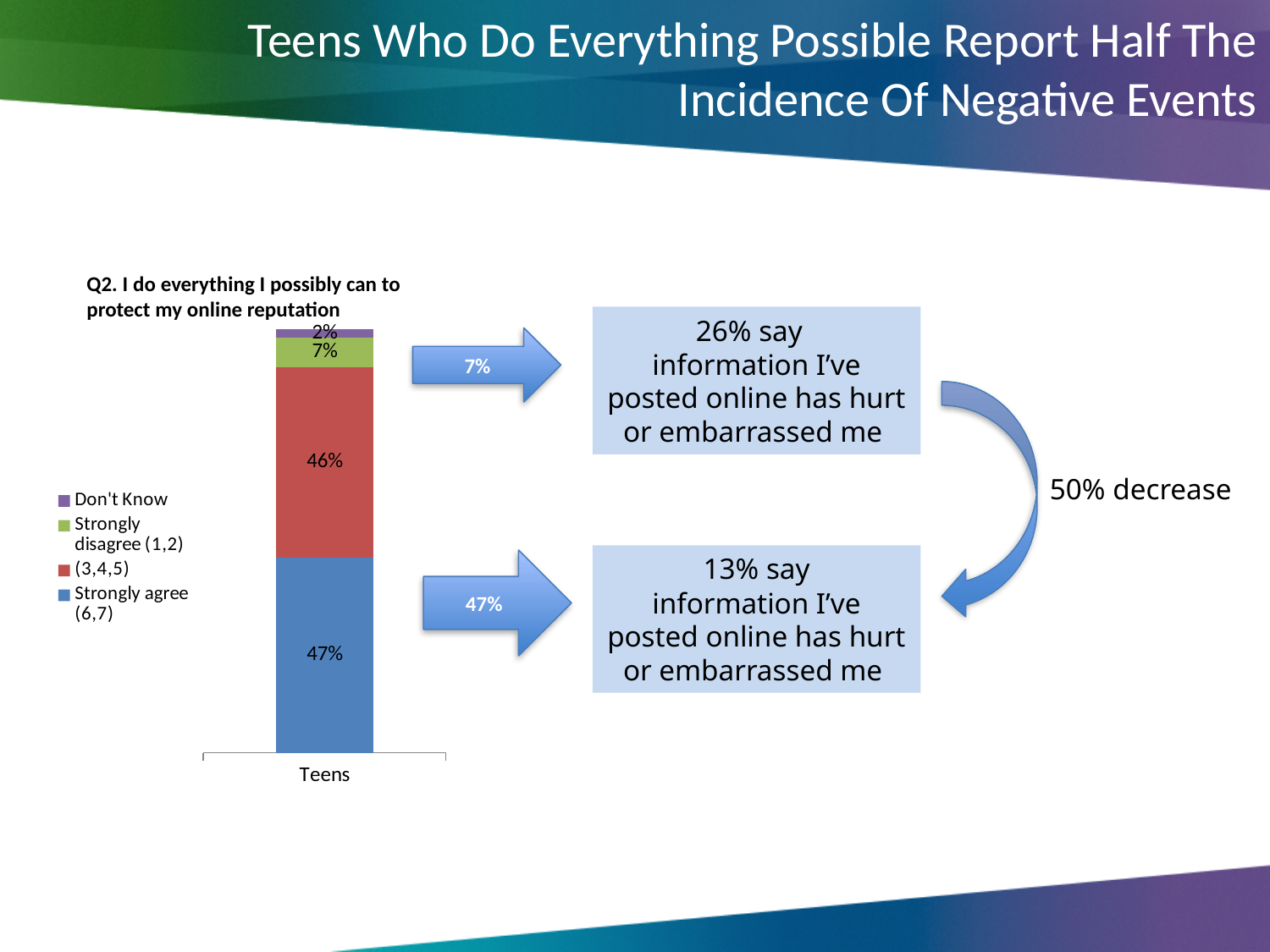
Which segment of the Teens bar is the smallest? Don't Know What percentage of Teens are in the Strongly agree (6,7) segment? 47% Which segment of the Teens bar is the largest? Strongly agree (6,7) What percentage of Teens are in the Strongly disagree (1,2) segment? 7% What is the title of the chart? Q2. I do everything I possibly can to protect my online reputation What percentage of Teens are in the (3,4,5) segment? 46% What kind of chart is shown on the slide? Stacked bar chart How many categories are shown on the x axis of the chart? 1 What is the difference between the Strongly agree (6,7) and Strongly disagree (1,2) percentages for Teens? 40% Which is larger for Teens: the (3,4,5) segment or the Strongly disagree (1,2) segment? (3,4,5) What percentage of Teens answered Don't Know? 2% How many series does the chart legend list? 4